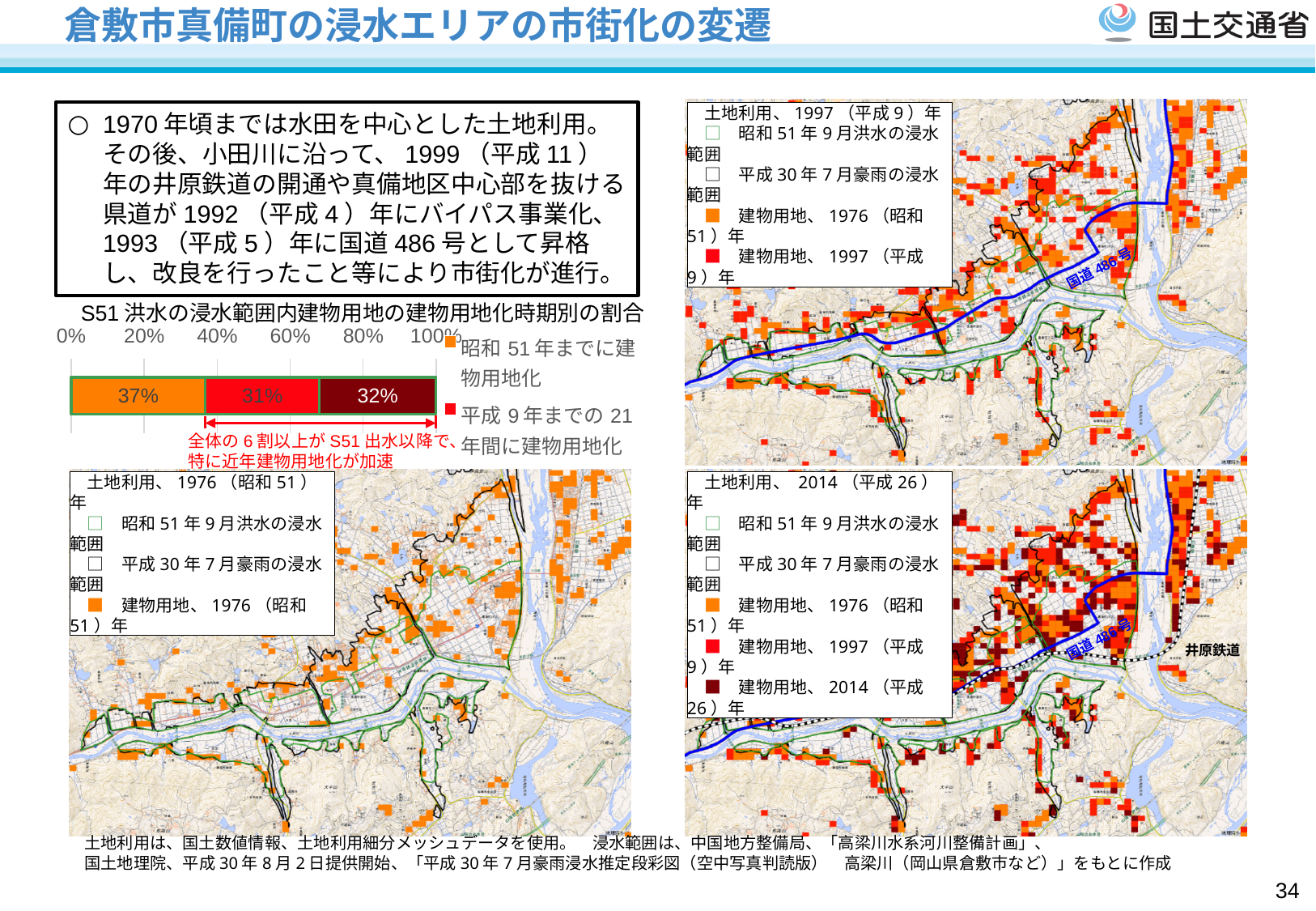
What colour is the segment for 昭和51年までに建物用地化 in the bar chart? Orange What is the title of the bar chart? S51洪水の浸水範囲内建物用地の建物用地化時期別の割合 In the bar chart, what percentage is shown in the dark red (rightmost) segment? 32% What is the difference in percentage points between the 昭和51年までに建物用地化 segment and the 平成9年までの21年間に建物用地化 segment? 6 percentage points What kind of chart is used to show the 建物用地化時期別の割合? Stacked horizontal bar chart Which segment of the bar chart has the largest share? 昭和51年までに建物用地化 (37%) What is the total of the three segments in the stacked bar? 100% How many segments does the stacked bar contain? 3 Which segment of the bar chart has the smallest share? 平成9年までの21年間に建物用地化 (31%) In the bar chart, what percentage is shown for 昭和51年までに建物用地化? 37% In the bar chart, what percentage is shown for 平成9年までの21年間に建物用地化? 31% Which is larger in the bar chart: the share for 昭和51年までに建物用地化 or the share for 平成9年までの21年間に建物用地化? 昭和51年までに建物用地化